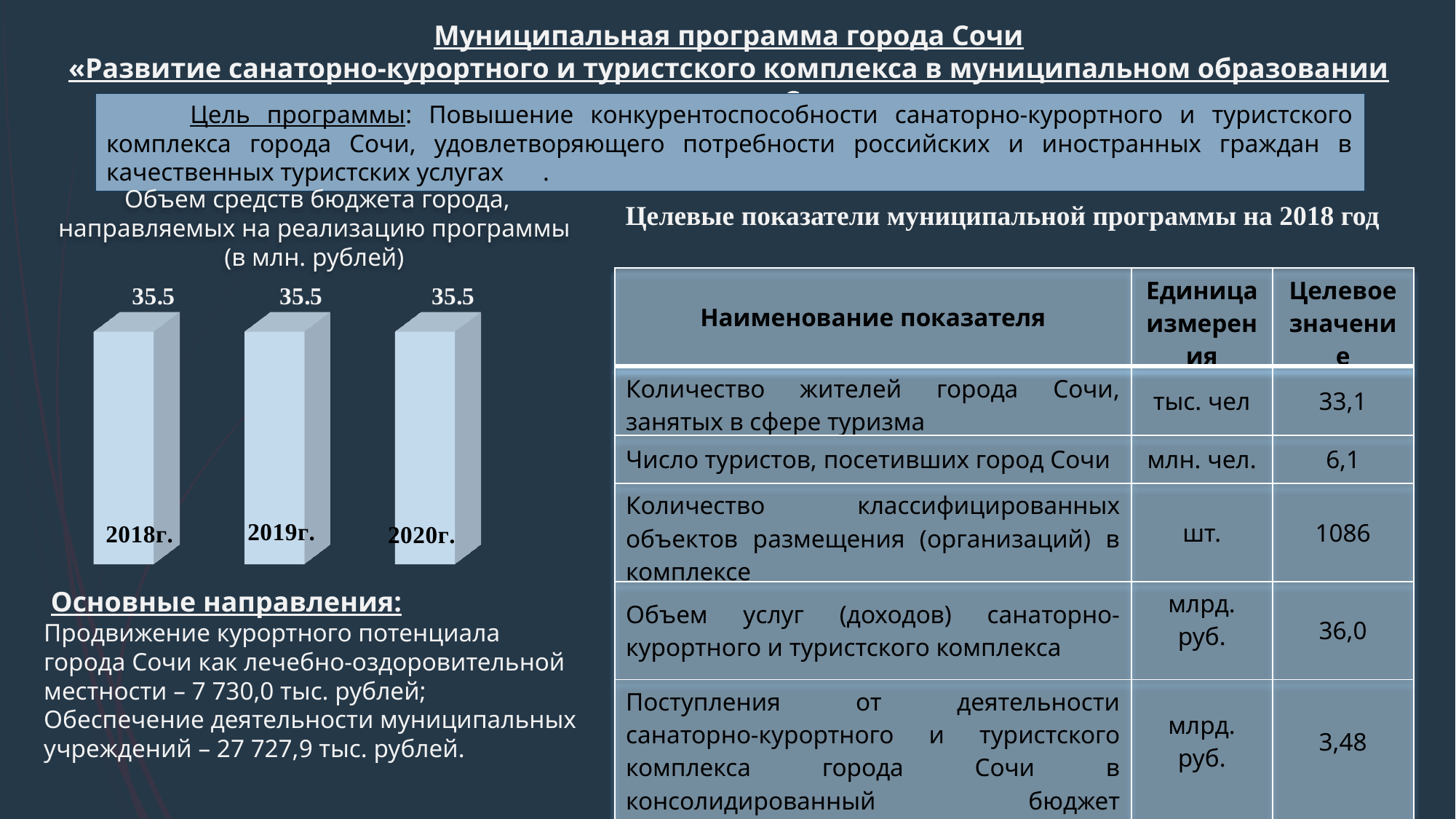
In what units are the values in the chart expressed, according to its title? млн. рублей Do the values in the chart rise, fall, or stay the same from 2018г. to 2020г.? Stay the same What is the value for 2019г. in the bar chart? 35.5 What kind of chart is shown on the slide? Bar chart Which year is the first category on the x axis of the chart? 2018г. Is the value for 2020г. in the chart greater or less than 30? greater What is the value for 2020г. in the bar chart? 35.5 What is the value for 2018г. in the bar chart? 35.5 How many bars (years) are shown in the chart? 3 What is the difference between the values for 2019г. and 2018г. in the chart? 0